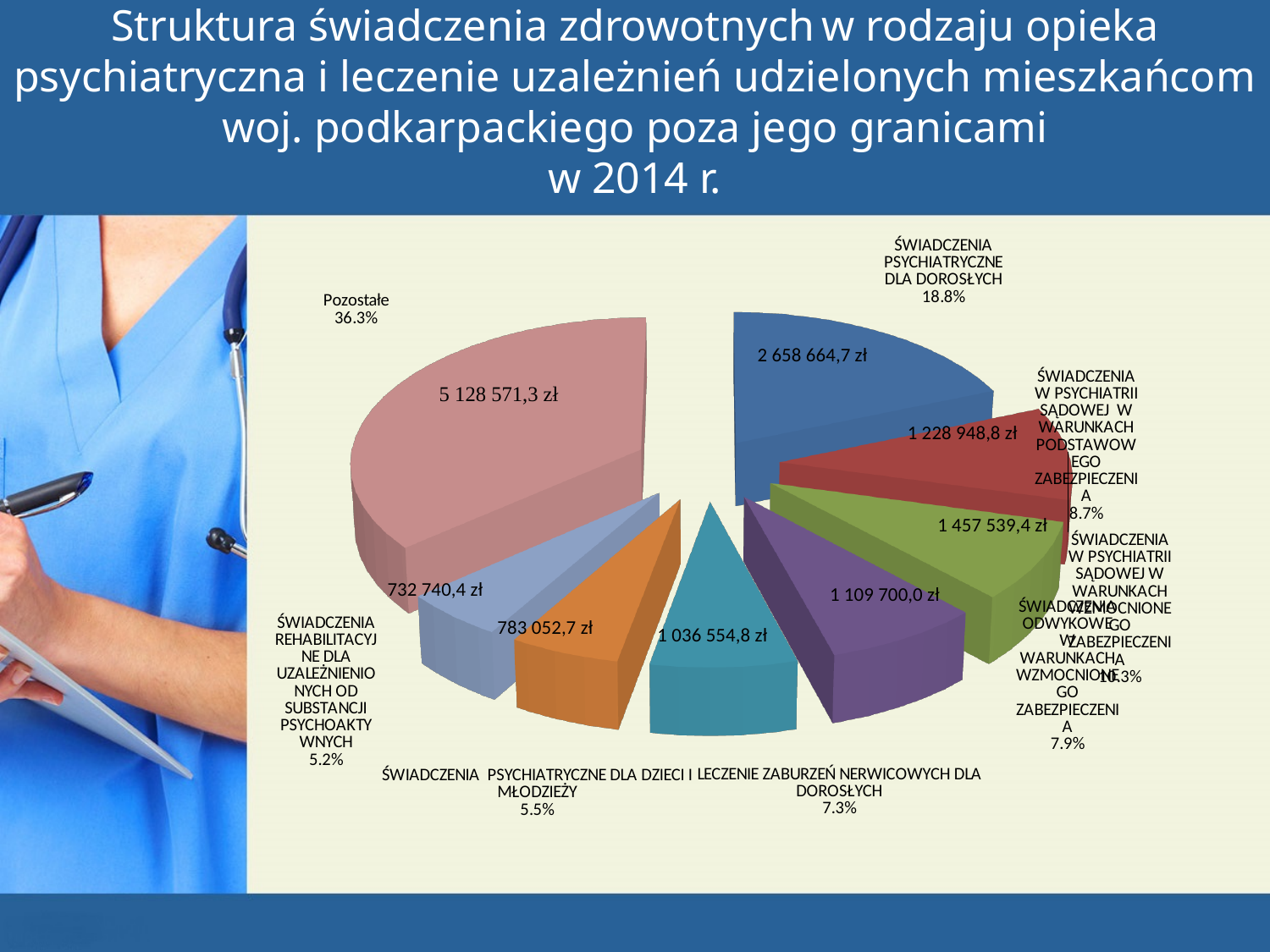
What share of the pie does Pozostałe represent? 36.3% Which category has the smallest share of the pie? ŚWIADCZENIA REHABILITACYJNE DLA UZALEŻNIENIONYCH OD SUBSTANCJI PSYCHOAKTYWNYCH How many slices does the pie chart have? 8 What is the value shown for LECZENIE ZABURZEŃ NERWICOWYCH DLA DOROSŁYCH? 1 036 554,8 zł Which is larger: the value for ŚWIADCZENIA PSYCHIATRYCZNE DLA DOROSŁYCH or the value for ŚWIADCZENIA W PSYCHIATRII SĄDOWEJ W WARUNKACH PODSTAWOWEGO ZABEZPIECZENIA? ŚWIADCZENIA PSYCHIATRYCZNE DLA DOROSŁYCH What is the value shown for ŚWIADCZENIA PSYCHIATRYCZNE DLA DOROSŁYCH? 2 658 664,7 zł Which category has the largest share of the pie? Pozostałe What is the value shown for ŚWIADCZENIA PSYCHIATRYCZNE DLA DZIECI I MŁODZIEŻY? 783 052,7 zł What share of the pie does ŚWIADCZENIA PSYCHIATRYCZNE DLA DOROSŁYCH represent? 18.8% What kind of chart is shown on the slide? pie chart What is the value shown for the Pozostałe slice? 5 128 571,3 zł What is the difference in percentage points between the share of Pozostałe and the share of ŚWIADCZENIA PSYCHIATRYCZNE DLA DOROSŁYCH? 17.5 percentage points